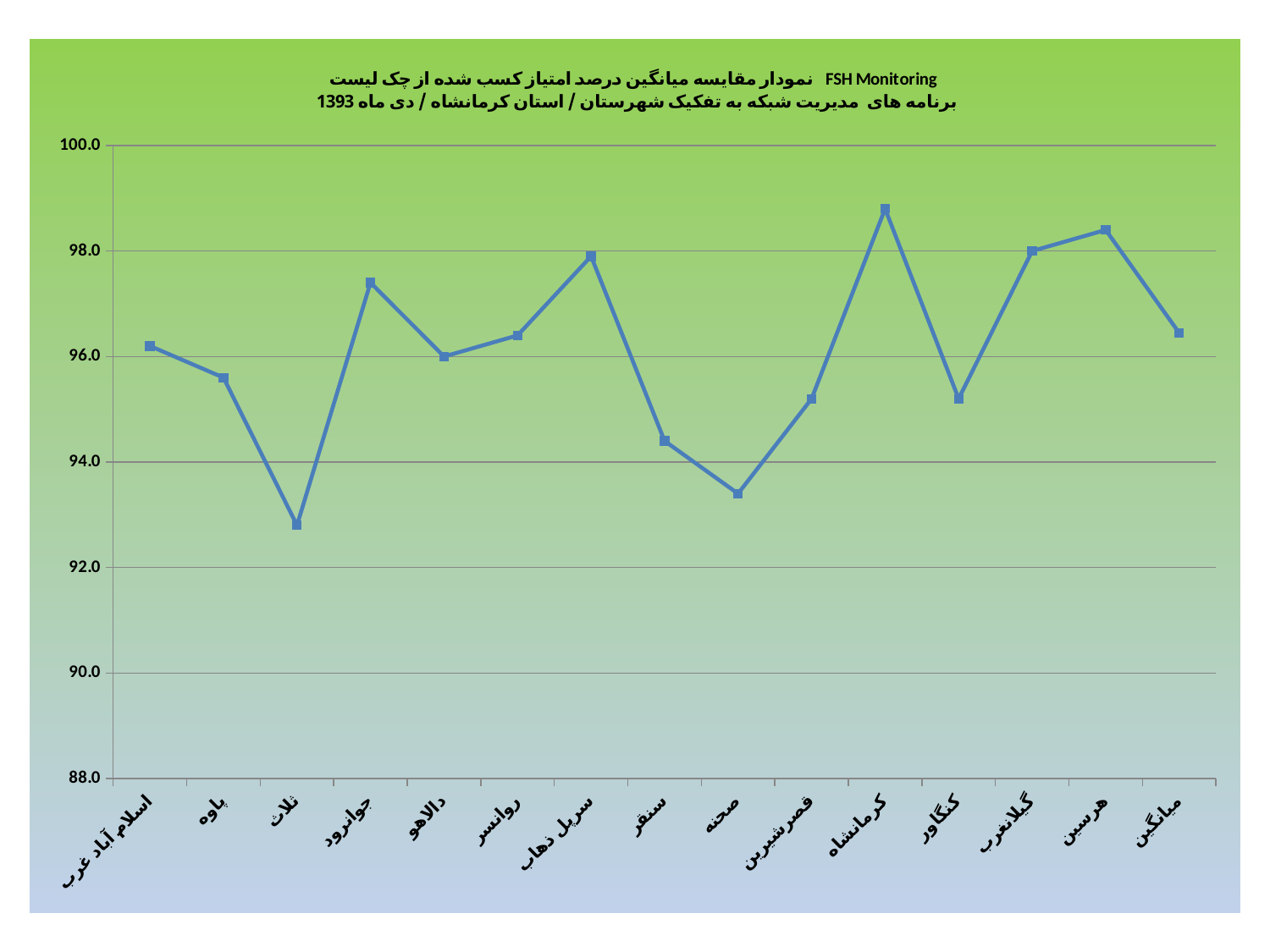
What is the value for دالاهو? 96.0 Is the value for ثلاث greater or less than 94.0? less Which monitoring program is named in the chart title? FSH Monitoring How many categories are plotted along the x axis? 15 Which category has the lowest value? ثلاث Which is larger, the value for جوانرود or the value for پاوه? جوانرود Which category has the highest value? کرمانشاه Is the value for صحنه greater or less than 94.0? less What is the value for گیلانغرب? 98.0 Do the values rise or fall from کنگاور to هرسین? rise What kind of chart is shown on the slide? line chart Is the value for کرمانشاه greater or less than 98.0? greater